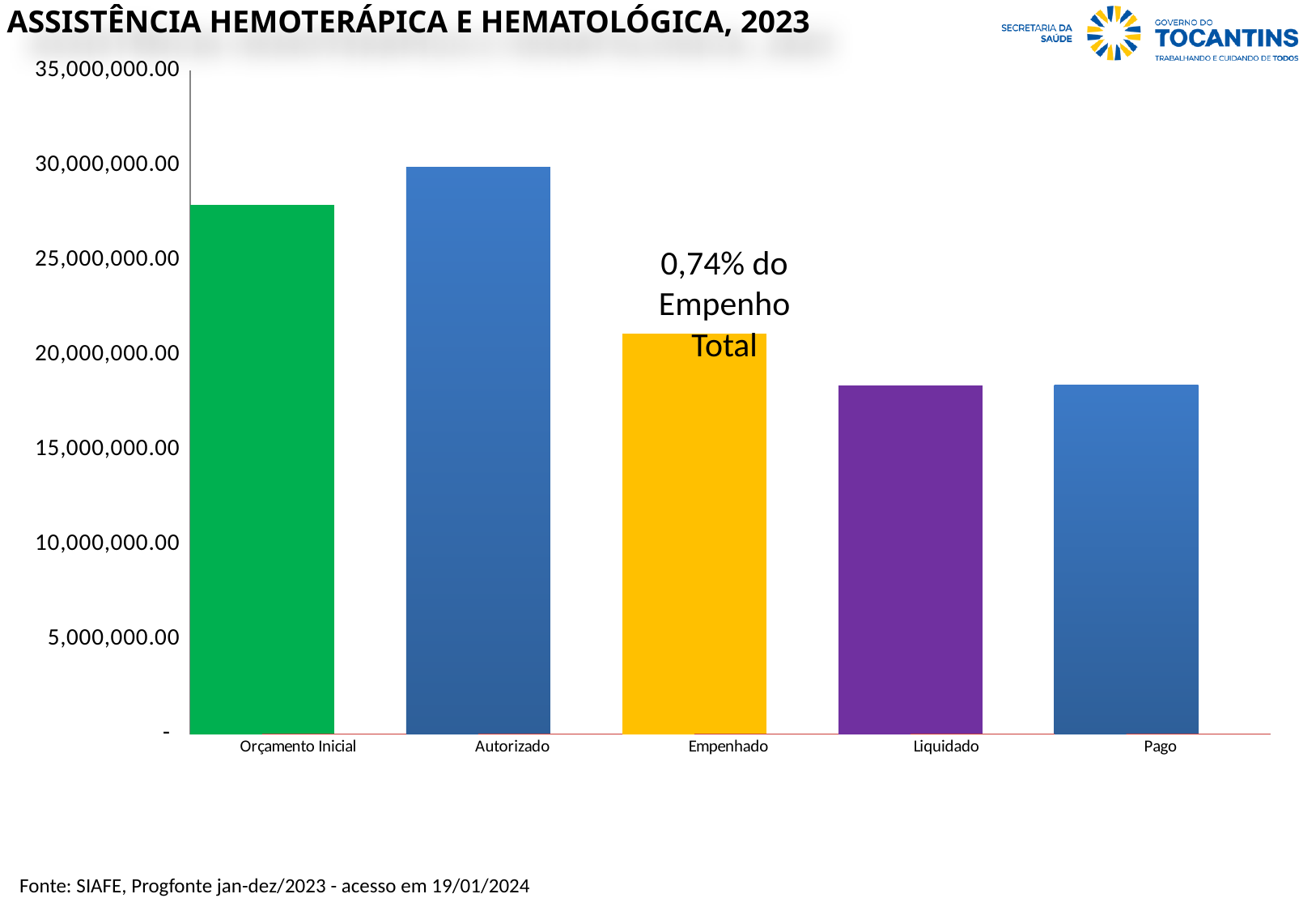
Which category has the highest value? Autorizado Is the value for Pago greater or less than 20,000,000.00? less What text annotation is shown above the Empenhado bar? 0,74% do Empenho Total Is the value for Liquidado greater or less than 20,000,000.00? less Is the value for Empenhado greater or less than 20,000,000.00? greater How many categories are plotted on the x axis? 5 Which is larger, the value for Autorizado or the value for Orçamento Inicial? Autorizado What kind of chart is shown on the slide? bar chart What is the title of the chart? ASSISTÊNCIA HEMOTERÁPICA E HEMATOLÓGICA, 2023 Which is larger, the value for Empenhado or the value for Liquidado? Empenhado